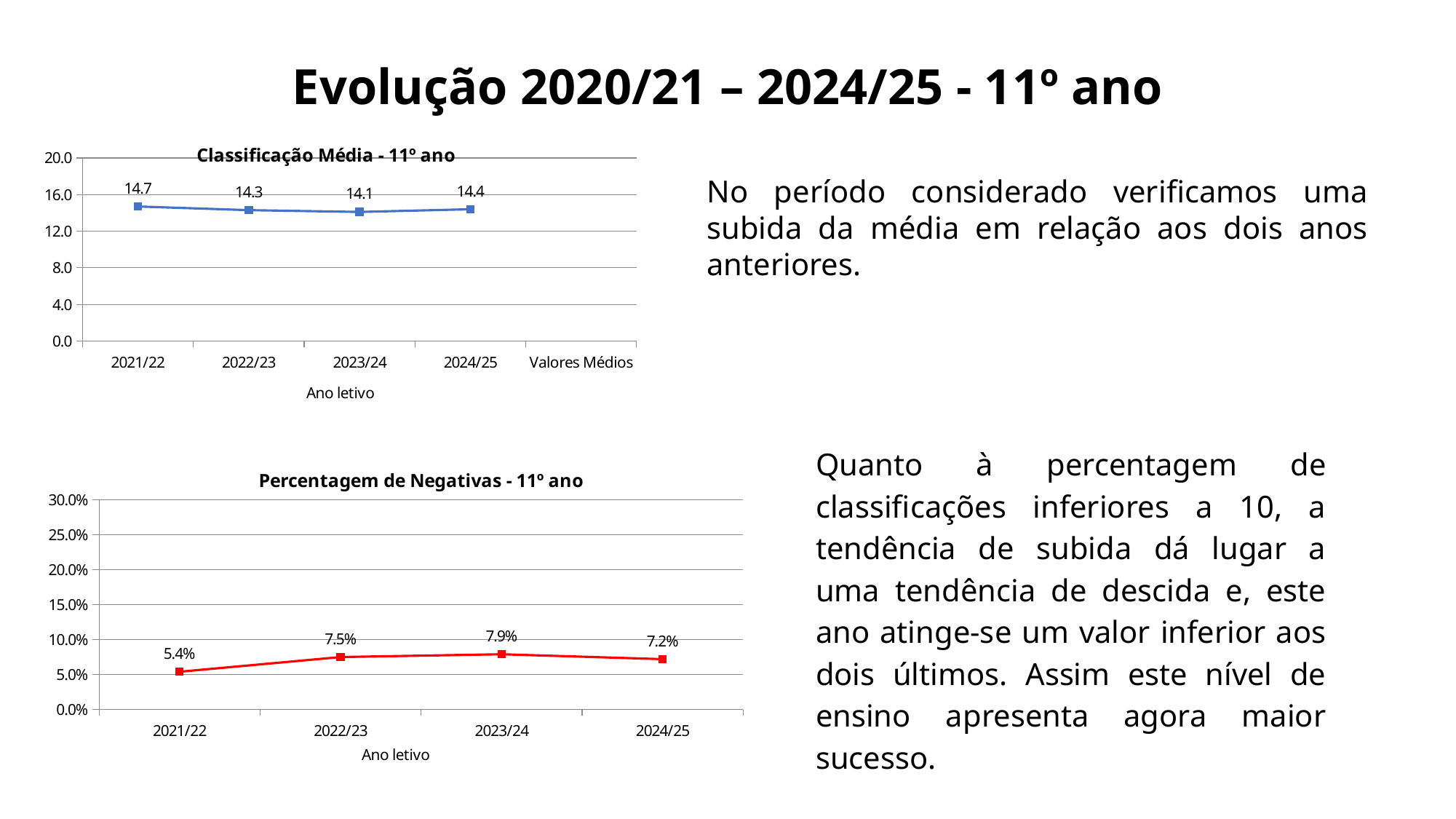
In the 'Percentagem de Negativas - 11º ano' chart, is the value for 2021/22 greater or less than 10.0%? less In the 'Percentagem de Negativas - 11º ano' chart, which school year has the highest value? 2023/24 In the 'Classificação Média - 11º ano' chart, what is the difference between the values for 2024/25 and 2023/24? 0.3 In the 'Classificação Média - 11º ano' chart, what is the value for 2021/22? 14.7 In the 'Classificação Média - 11º ano' chart, what is the value for 2023/24? 14.1 In the 'Percentagem de Negativas - 11º ano' chart, how many school years are plotted? 4 In the 'Percentagem de Negativas - 11º ano' chart, what is the value for 2022/23? 7.5% In the 'Classificação Média - 11º ano' chart, which school year has the lowest value? 2023/24 In the 'Percentagem de Negativas - 11º ano' chart, which school year has the lowest value? 2021/22 In the 'Classificação Média - 11º ano' chart, which school year has the highest value? 2021/22 In the 'Percentagem de Negativas - 11º ano' chart, what is the value for 2024/25? 7.2% What kind of chart is 'Classificação Média - 11º ano'? Line chart